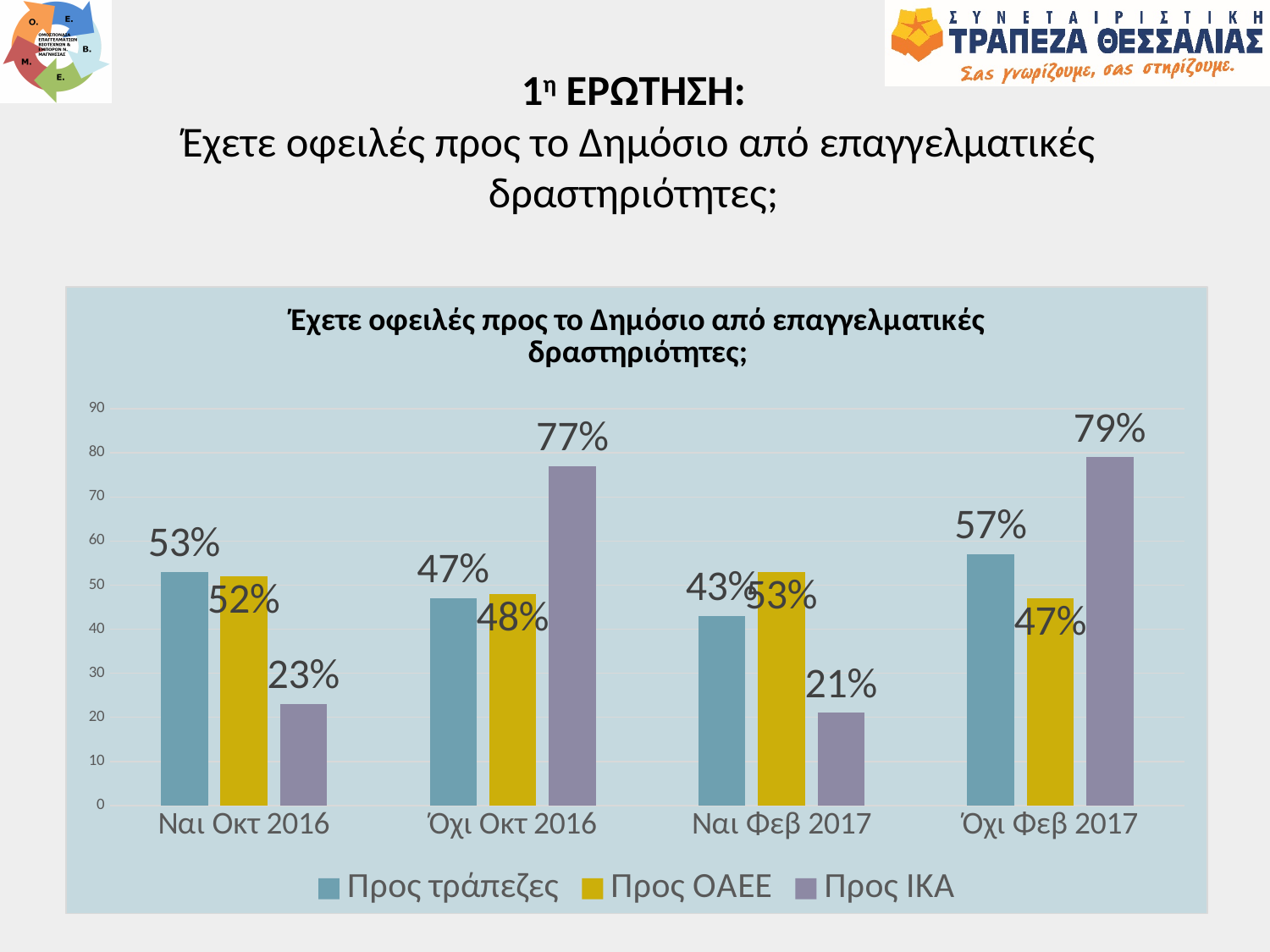
How many categories are shown on the x axis? 4 In which category is the Προς ΙΚΑ value the lowest? Ναι Φεβ 2017 Is the value for Προς ΙΚΑ in Ναι Οκτ 2016 greater or less than 30? less How many series does the legend list? 3 Which series is shown in yellow in the legend? Προς ΟΑΕΕ What is the value for Προς ΟΑΕΕ in the Όχι Φεβ 2017 category? 47% What is the value for Προς ΙΚΑ in the Όχι Οκτ 2016 category? 77% What is the value for Προς τράπεζες in the Ναι Φεβ 2017 category? 43% What is the difference between the Προς ΙΚΑ values for Όχι Φεβ 2017 and Ναι Φεβ 2017? 58% What type of chart is shown on the slide? bar chart In which category is the Προς ΙΚΑ value the highest? Όχι Φεβ 2017 Which is larger: Προς τράπεζες in Ναι Οκτ 2016 or Προς τράπεζες in Ναι Φεβ 2017? Ναι Οκτ 2016